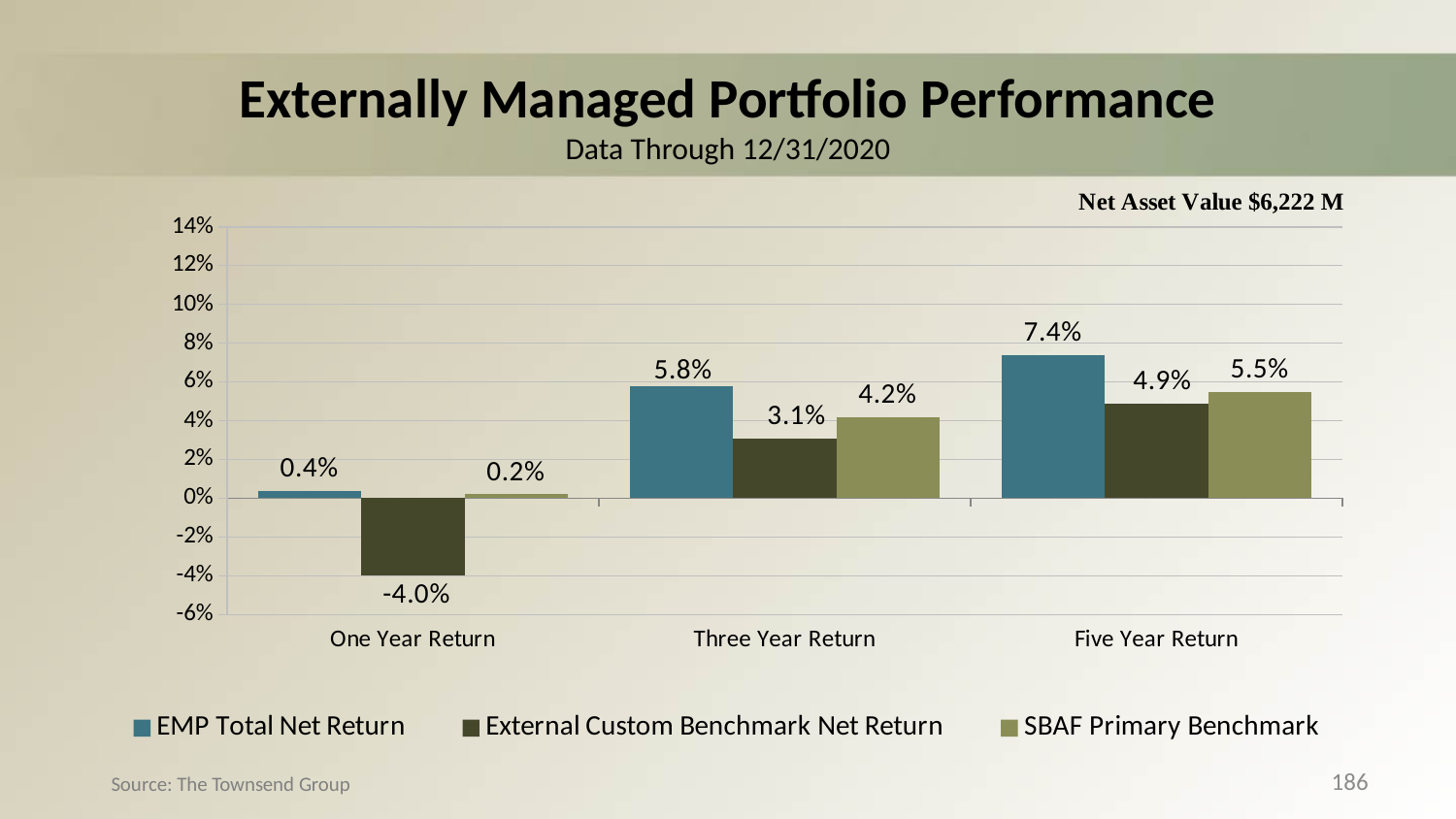
What is the SBAF Primary Benchmark value for the Three Year Return? 4.2% What is the EMP Total Net Return for the Five Year Return? 7.4% How many return periods are shown on the x axis? 3 Which period has the highest EMP Total Net Return? Five Year Return What Net Asset Value is stated on the slide? $6,222 M Which series has the lowest value for the One Year Return? External Custom Benchmark Net Return What is the External Custom Benchmark Net Return for the One Year Return? -4.0% Is the EMP Total Net Return for the Three Year Return greater or less than 4%? greater What kind of chart is shown on the slide? Bar chart For the Five Year Return, which is larger: the SBAF Primary Benchmark or the External Custom Benchmark Net Return? SBAF Primary Benchmark What is the difference between the EMP Total Net Return and the External Custom Benchmark Net Return for the Three Year Return? 2.7% How many series does the legend list? 3